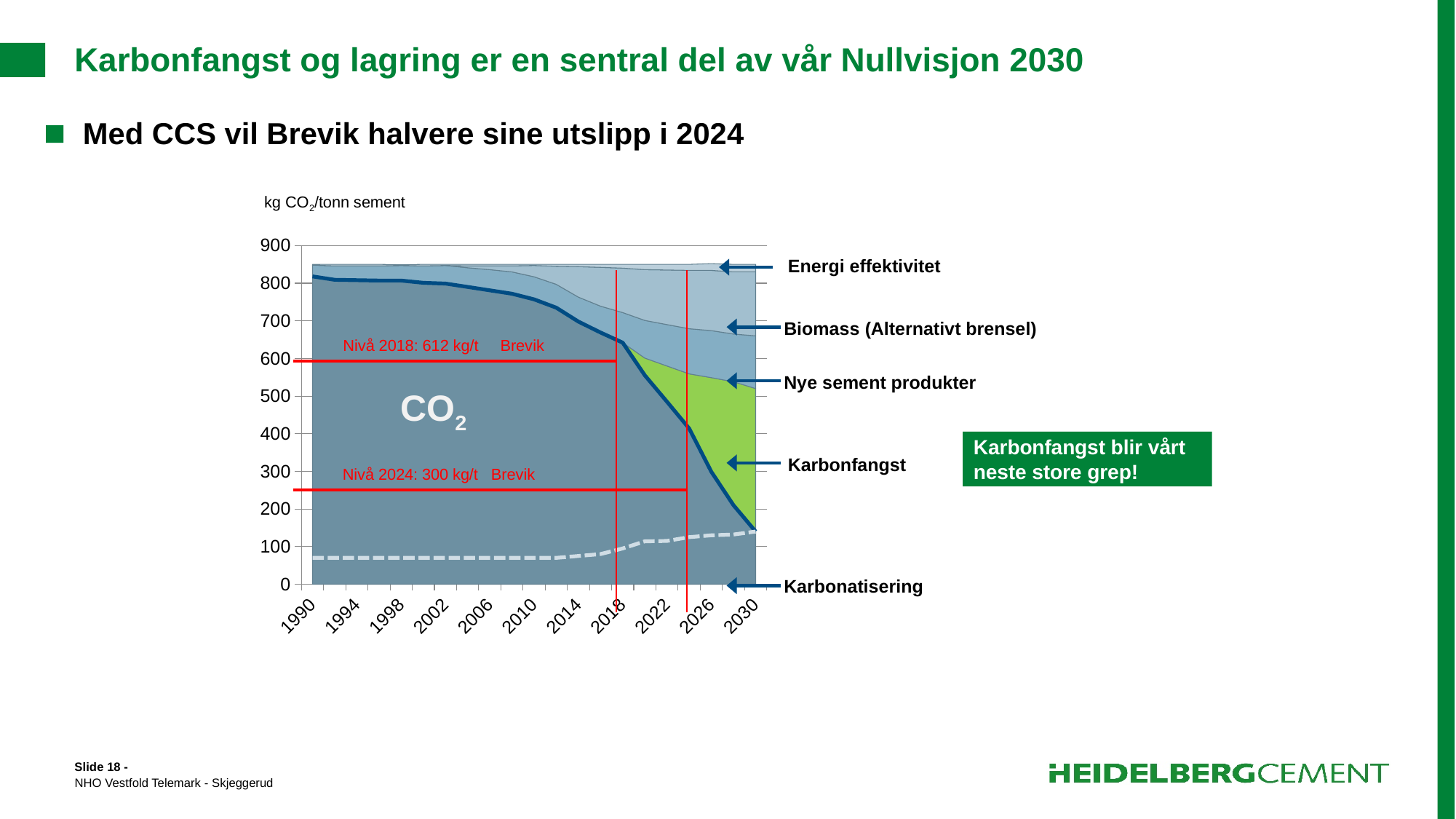
By how much does the annotated Brevik level fall from 2018 (612 kg/t) to 2024 (300 kg/t)? 312 kg/t Does the thick dark blue CO2 line rise or fall from 1990 to 2030? Fall Which labelled area of the chart is shown in green? Karbonfangst How many year labels are shown on the x axis? 11 What kind of chart is shown on the slide? Area chart Is the value of the thick dark blue line in 2030 greater or less than 200? less Is the value of the thick dark blue line in 1990 greater or less than 800? greater What unit is shown on the y axis of the chart? kg CO2/tonn sement Which annotated Brevik level is higher, 2018 or 2024? 2018 What is the Brevik emission level for 2018 annotated on the chart? 612 kg/t What is the Brevik emission level for 2024 annotated on the chart? 300 kg/t Is the value of the thick dark blue line in 2010 greater or less than 700? greater